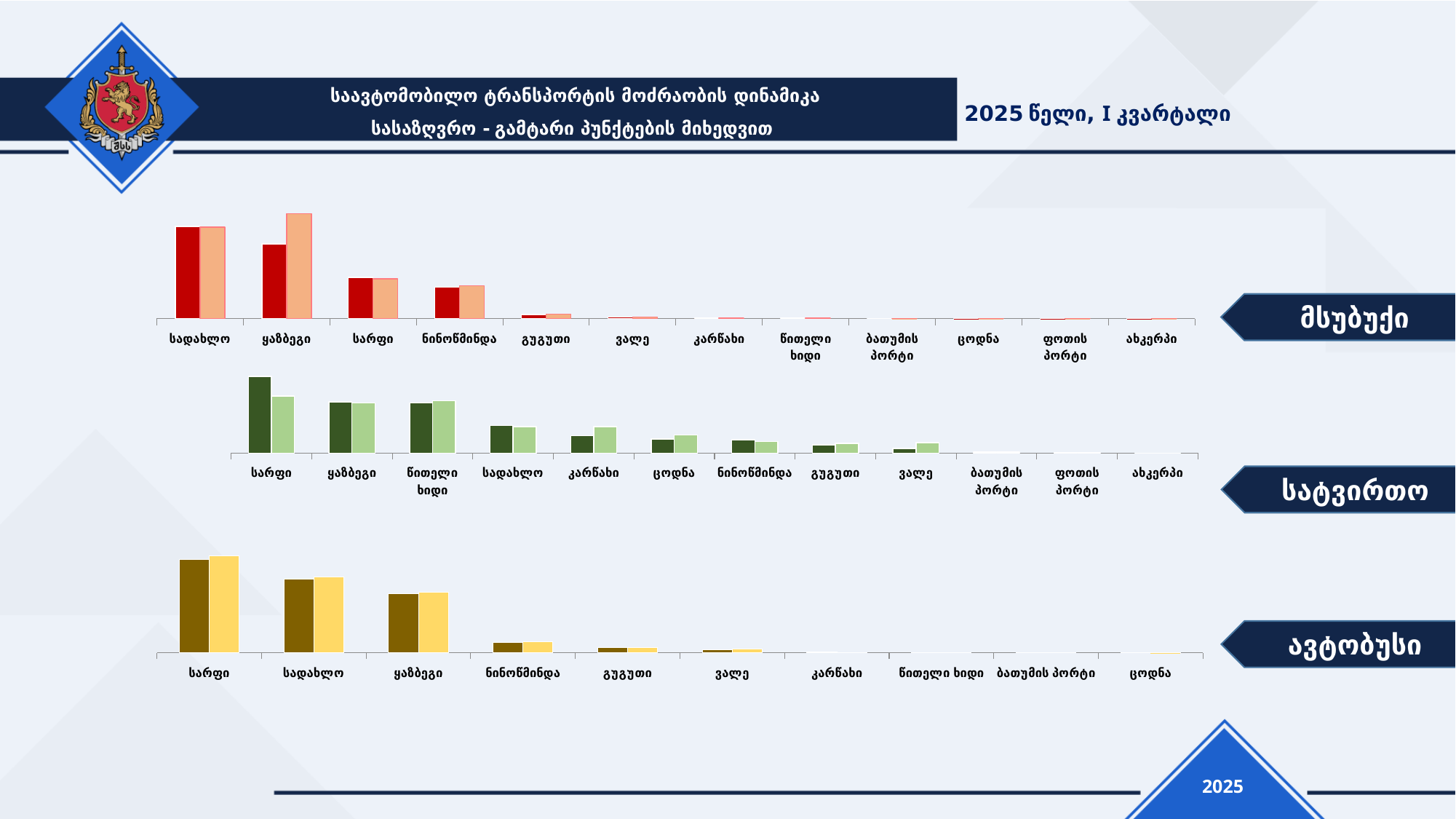
In the middle chart (სატვირთო), which category has the tallest bar? სარფი In the bottom chart (ავტობუსი), which category has the tallest bar? სარფი In the middle chart (სატვირთო), which has the larger bars, სადახლო or კარწახი? სადახლო In the top chart (მსუბუქი), which has the larger bars, სარფი or ნინოწმინდა? სარფი In the middle chart (სატვირთო), how many categories are shown on the x axis? 12 In the bottom chart (ავტობუსი), how many categories are shown on the x axis? 10 What type of chart is the top chart labelled მსუბუქი? Bar chart Which period is stated in the slide header next to the title? 2025 წელი, I კვარტალი In the top chart (მსუბუქი), which category has the tallest bar? ყაზბეგი In the top chart (მსუბუქი), how many categories are shown on the x axis? 12 In the bottom chart (ავტობუსი), which has the larger bars, სადახლო or ყაზბეგი? სადახლო